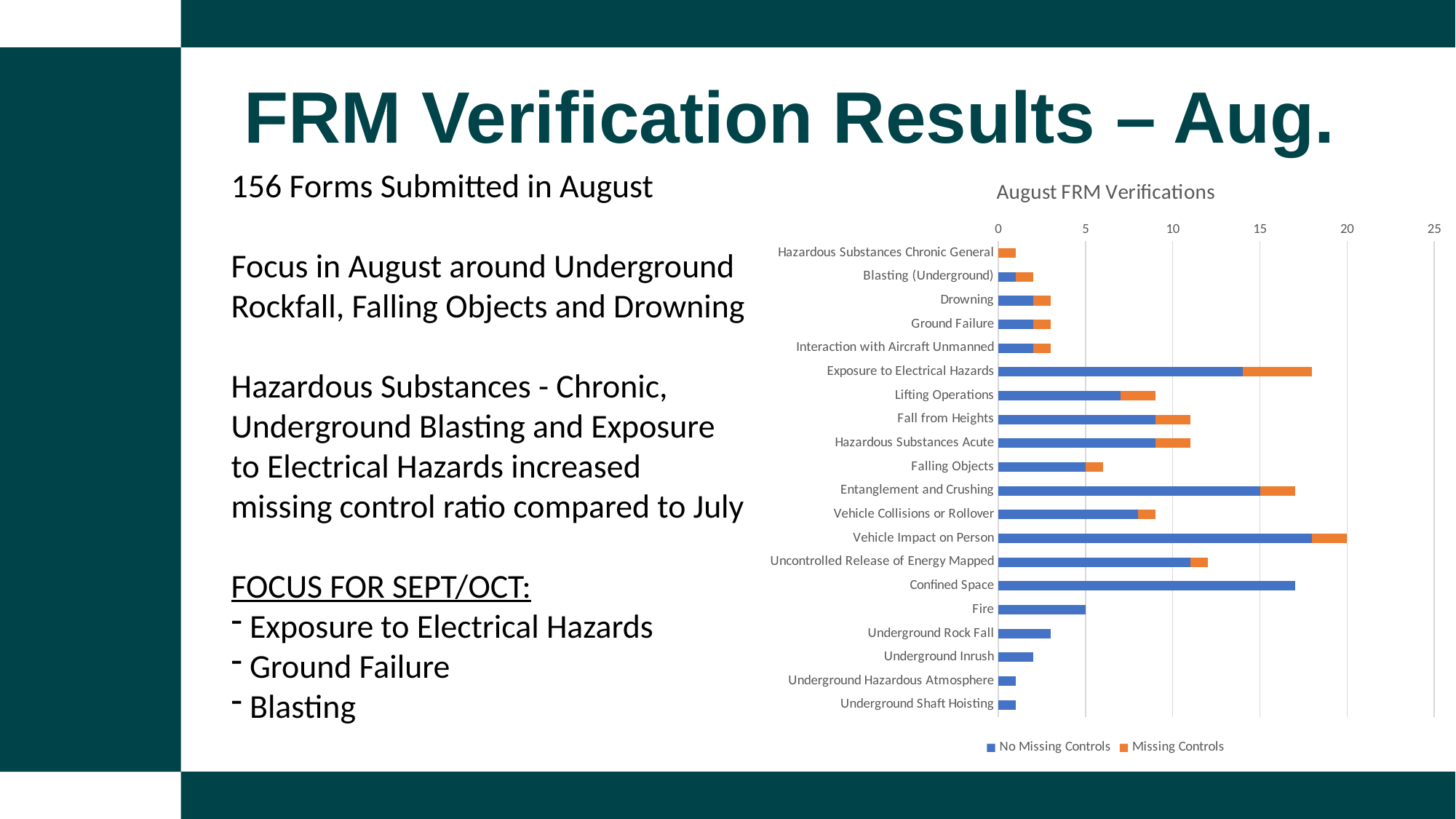
Is the total value for Drowning greater or less than 5? less How many categories are plotted on the chart? 20 What is the title of the chart? August FRM Verifications Which series is shown in orange in the chart legend? Missing Controls Which category has the longest total bar? Vehicle Impact on Person Which has the larger total bar, Exposure to Electrical Hazards or Lifting Operations? Exposure to Electrical Hazards Is the total value for Underground Rock Fall greater or less than 5? less What kind of chart is shown on the slide? bar chart Is the total value for Entanglement and Crushing greater or less than 15? greater How many series does the chart legend list? 2 Which has the larger total bar, Confined Space or Fire? Confined Space